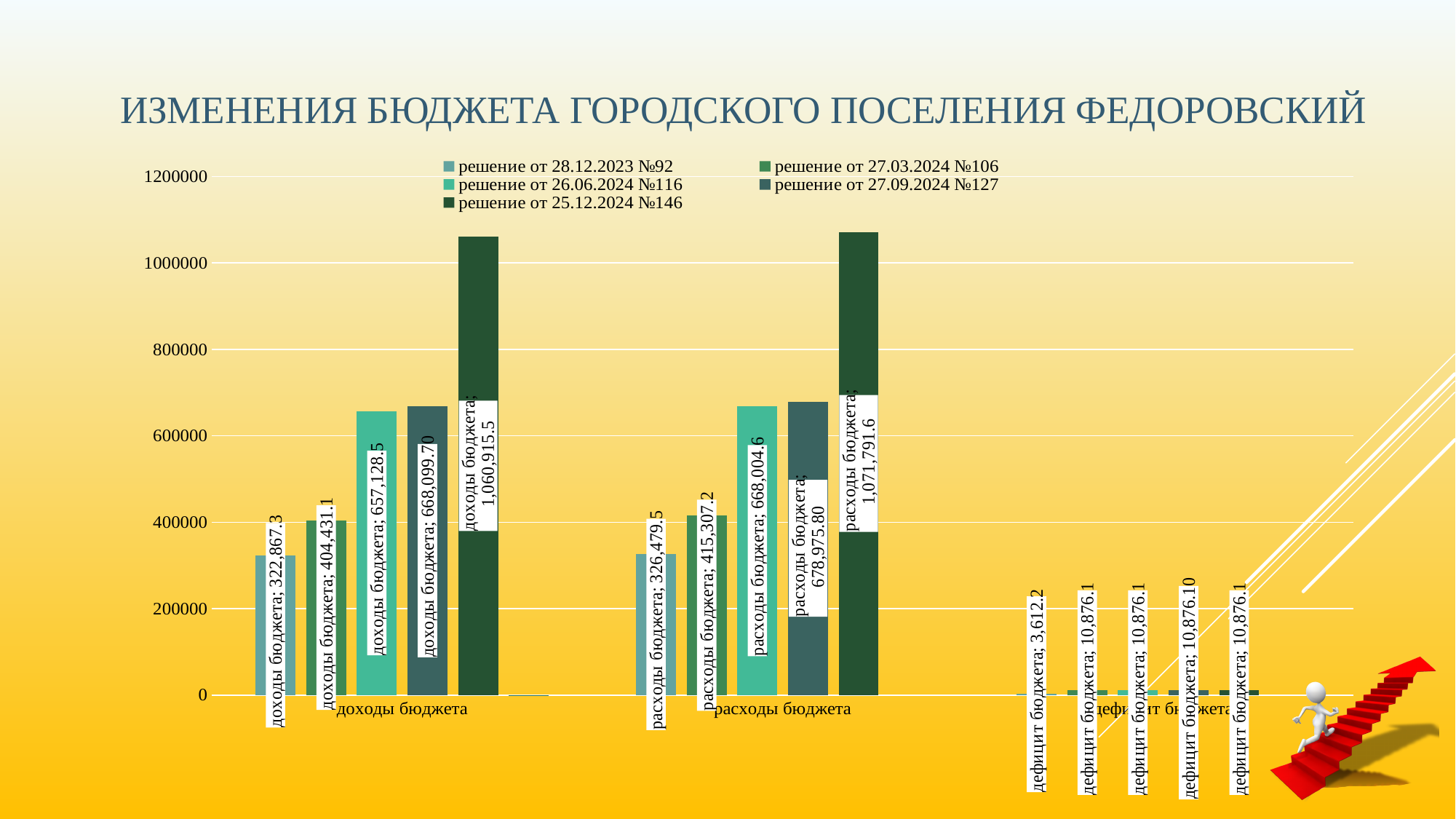
Is the value of расходы бюджета for решение от 25.12.2024 №146 greater or less than 1000000? greater Which series has the highest value for доходы бюджета? решение от 25.12.2024 №146 Which is larger: доходы бюджета for решение от 26.06.2024 №116 or доходы бюджета for решение от 27.09.2024 №127? решение от 27.09.2024 №127 How many series does the legend list? 5 Which series has the lowest value for расходы бюджета? решение от 28.12.2023 №92 What is the value of дефицит бюджета for решение от 28.12.2023 №92? 3,612.2 What is the value of расходы бюджета for решение от 27.09.2024 №127? 678,975.80 What kind of chart is shown on the slide? bar chart What is the difference between расходы бюджета and доходы бюджета for решение от 25.12.2024 №146? 10,876.1 What is the value of расходы бюджета for решение от 28.12.2023 №92? 326,479.5 What is the value of доходы бюджета for решение от 25.12.2024 №146? 1,060,915.5 How many categories are shown on the x axis? 3